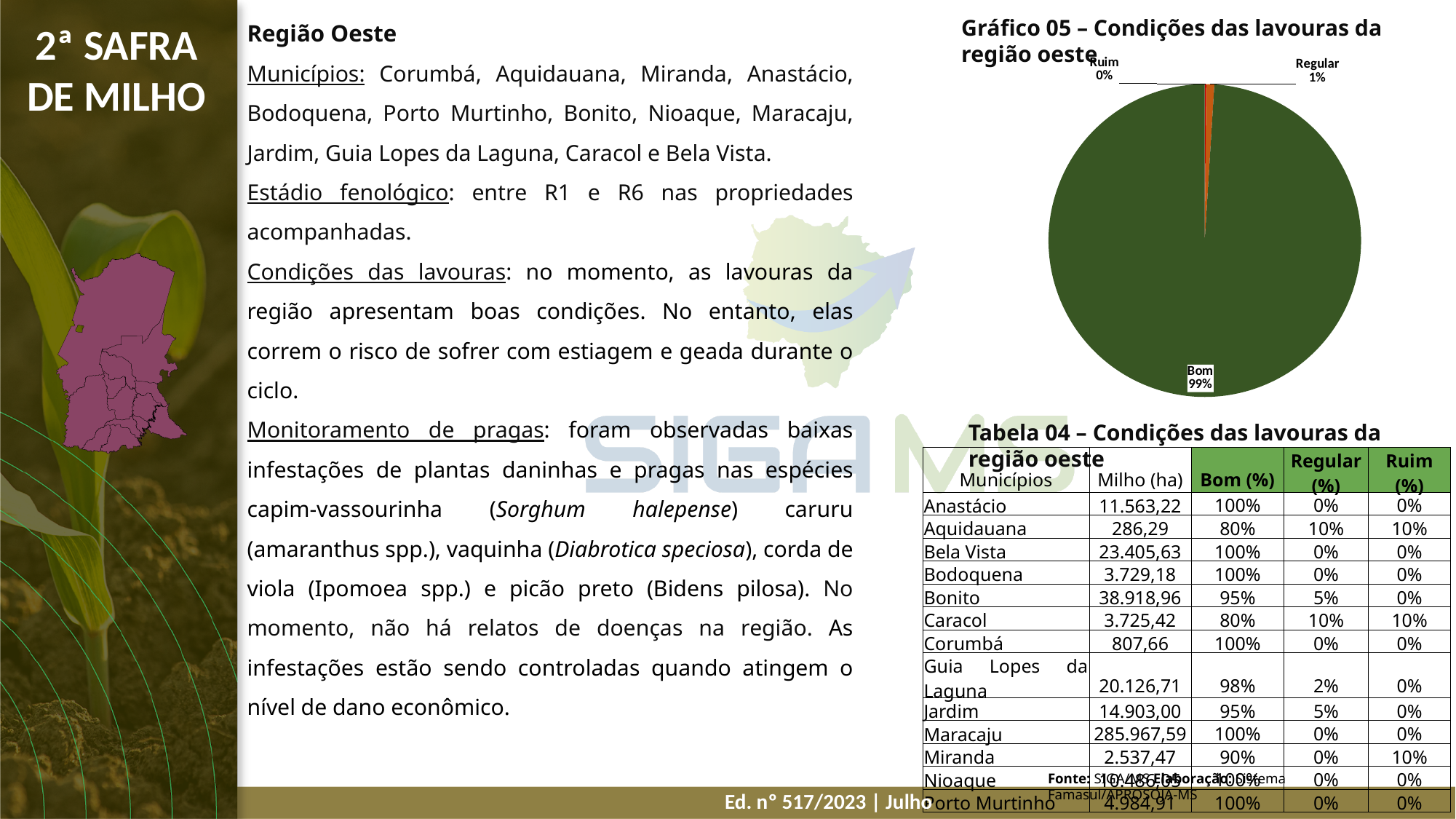
In the pie chart Gráfico 05, what share is labelled for Regular? 1% What is the title of the pie chart on the slide? Gráfico 05 – Condições das lavouras da região oeste What kind of chart is Gráfico 05 – Condições das lavouras da região oeste? pie chart In the pie chart Gráfico 05, what is the difference between the share for Bom and the share for Regular? 98% In the pie chart Gráfico 05, what colour is the Bom slice? dark green In the pie chart Gráfico 05, what share is labelled for Bom? 99% In the pie chart Gráfico 05, what share is labelled for Ruim? 0% In the pie chart Gráfico 05, which is larger, the share for Bom or the share for Regular? Bom In the pie chart Gráfico 05, which category has the largest slice? Bom In the pie chart Gráfico 05, which category has the smallest share? Ruim How many categories are labelled in the pie chart Gráfico 05? 3